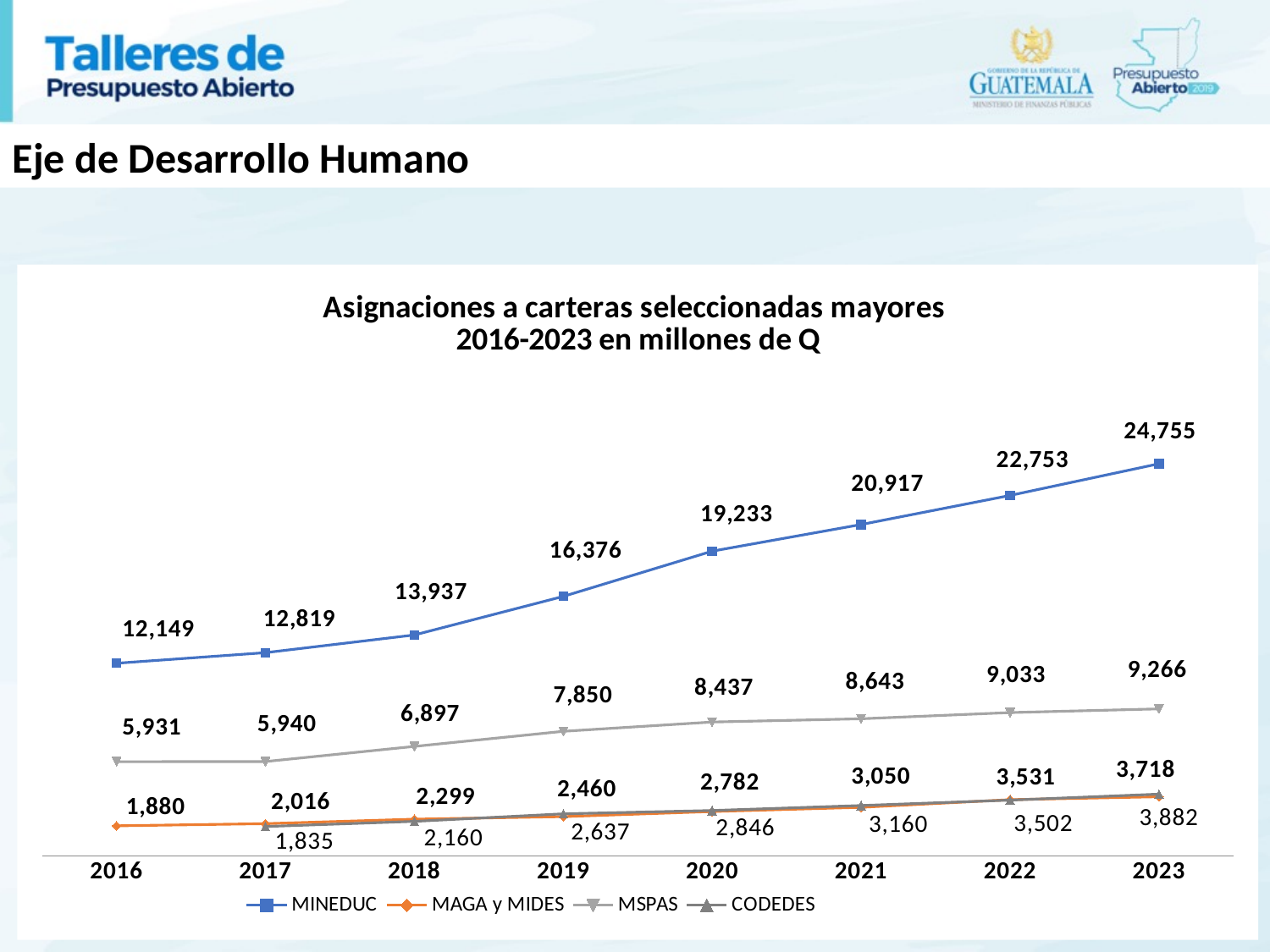
Does the MINEDUC series rise or fall from 2016 to 2023? Rises How many series does the legend list? 4 By how much did the MINEDUC value increase from 2016 to 2023? 12,606 What is the value for MINEDUC in 2023? 24,755 What is the difference between the MSPAS values for 2023 and 2022? 233 How many years are shown on the x axis? 8 Which series has the highest value in 2023? MINEDUC What is the value for MINEDUC in 2016? 12,149 What is the value for MAGA y MIDES in 2016? 1,880 What is the title of the chart? Asignaciones a carteras seleccionadas mayores 2016-2023 en millones de Q What kind of chart is shown on the slide? Line chart What is the value for MSPAS in 2019? 7,850